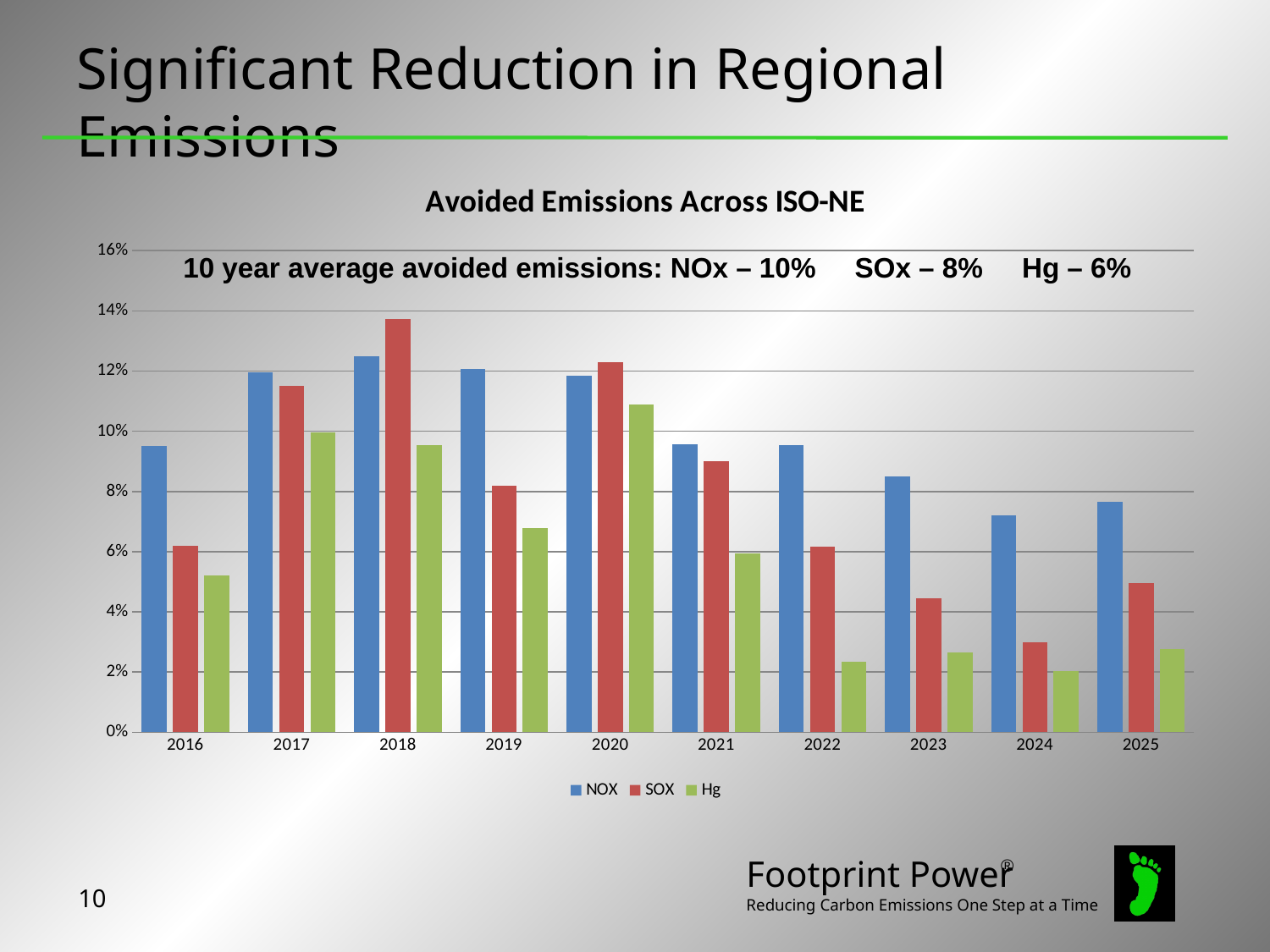
In which year is the SOX bar highest? 2018 In which year is the Hg bar highest? 2020 Is the Hg value for 2022 greater or less than 4%? less In which year is the SOX bar lowest? 2024 How many years are shown on the x axis? 10 How many series does the legend list? 3 What is the title of the chart? Avoided Emissions Across ISO-NE Do the Hg values rise or fall from 2020 to 2025? Fall In 2016, which is larger, the NOX value or the SOX value? NOX Is the SOX value for 2018 greater or less than 12%? greater According to the text on the chart, what is the 10 year average avoided emissions for NOx? 10% What kind of chart is shown on the slide? Bar chart